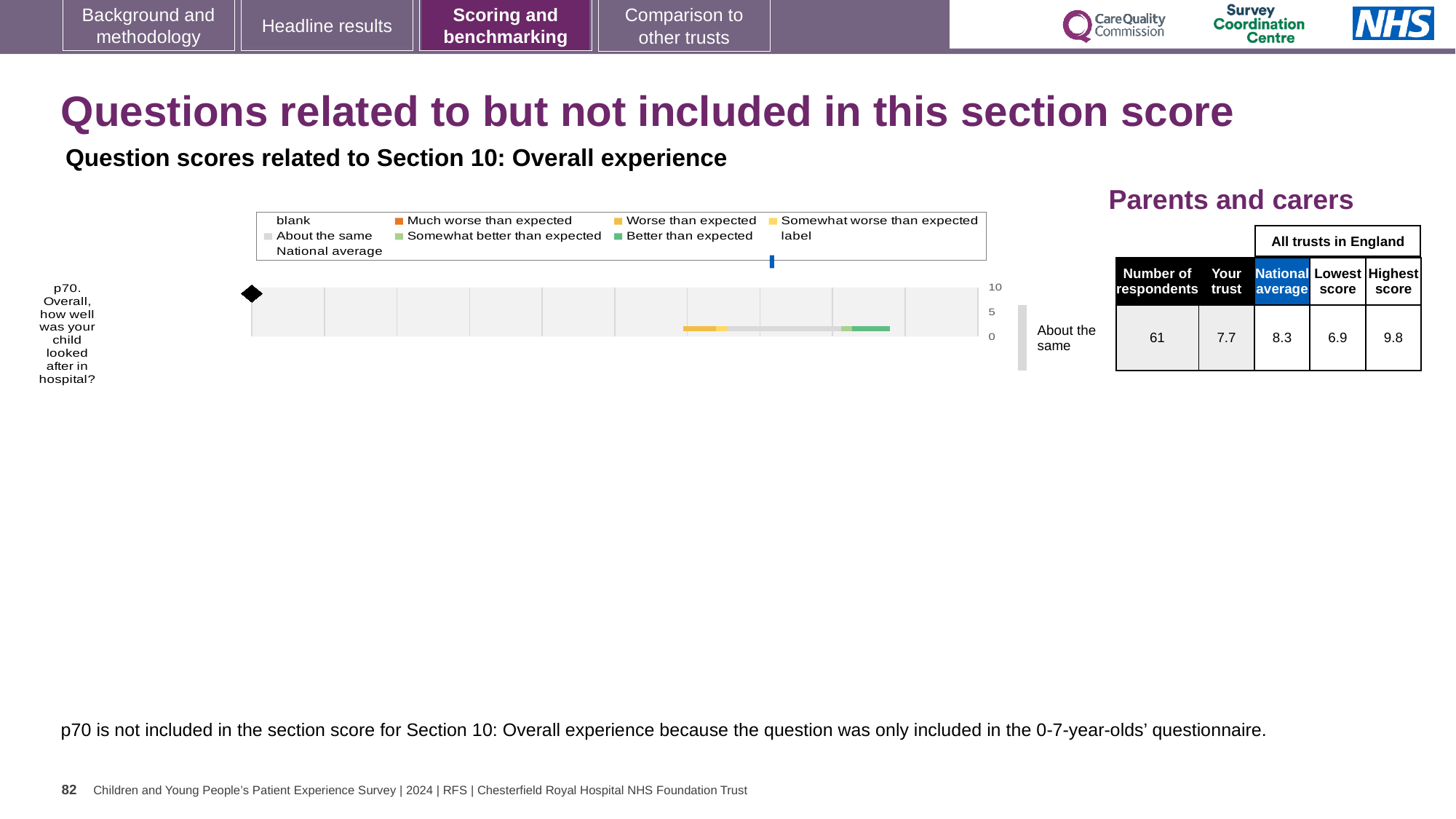
What is the difference between the national average and the 'Your trust' score for p70? 0.6 Which respondent group does the chart relate to? Parents and carers What is the lowest score among all trusts in England for p70? 6.9 What is the difference between the highest and lowest trust scores for p70? 2.9 What kind of chart is used to show the p70 question score? bar chart How many respondents answered p70? 61 Which benchmark category is the trust's p70 score placed in? About the same Which is higher for p70: the 'Your trust' score or the national average? National average What is the national average score for p70? 8.3 How many questions are plotted in the chart? 1 What is the 'Your trust' score for p70 (Overall, how well was your child looked after in hospital?)? 7.7 What is the highest score among all trusts in England for p70? 9.8